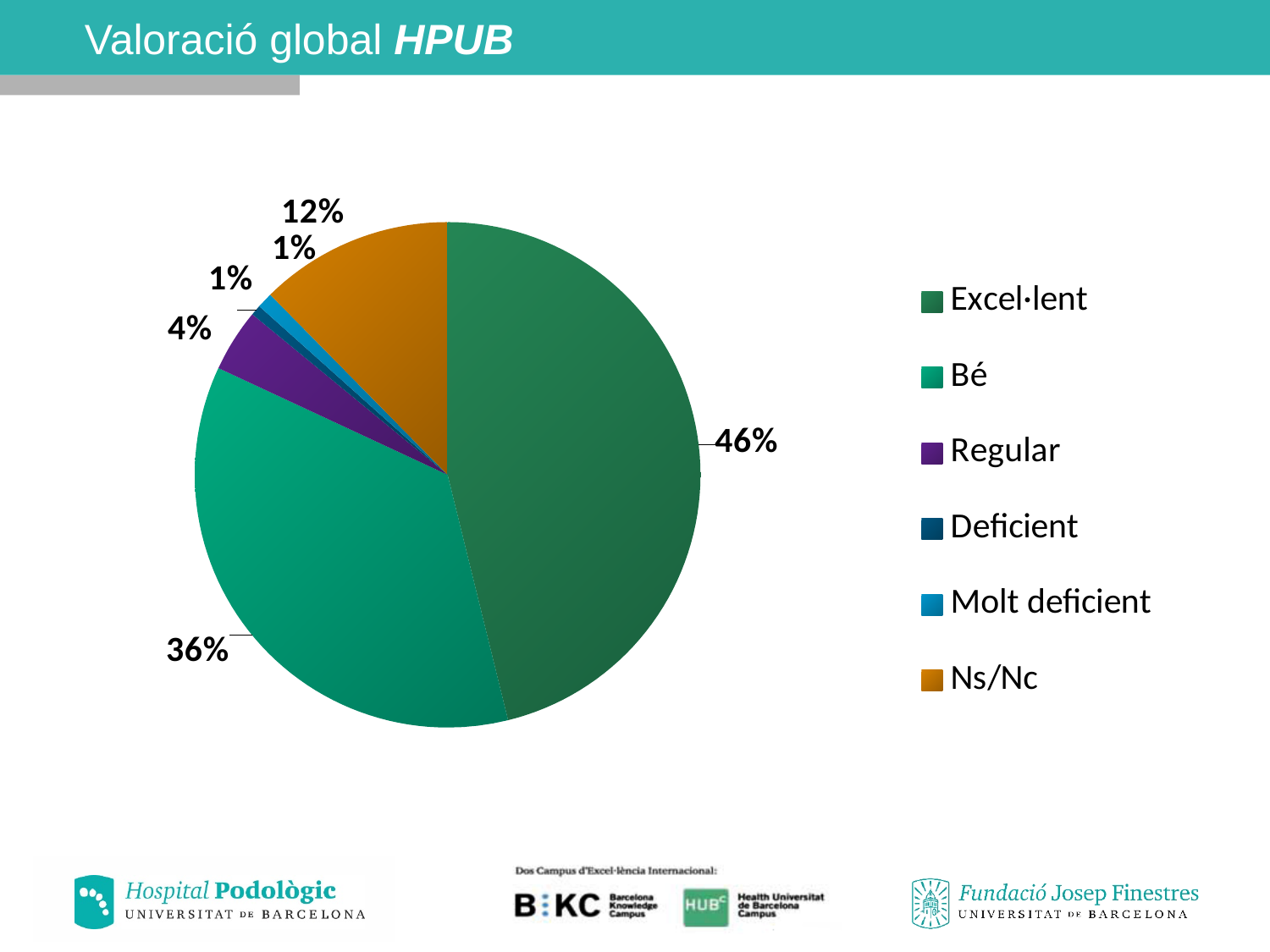
What is the title of the slide containing the chart? Valoració global HPUB What kind of chart is shown on the slide? pie chart What share of the pie does Regular have? 4% What share of the pie does Bé have? 36% Which is larger, the share for Ns/Nc or the share for Regular? Ns/Nc What share of the pie does Deficient have? 1% Which category has the largest slice of the pie? Excel·lent What share of the pie does Excel·lent have? 46% What is the difference in percentage points between Excel·lent and Bé? 10% What share of the pie does Ns/Nc have? 12% How many categories does the legend list? 6 What is the combined share of Excel·lent and Bé? 82%